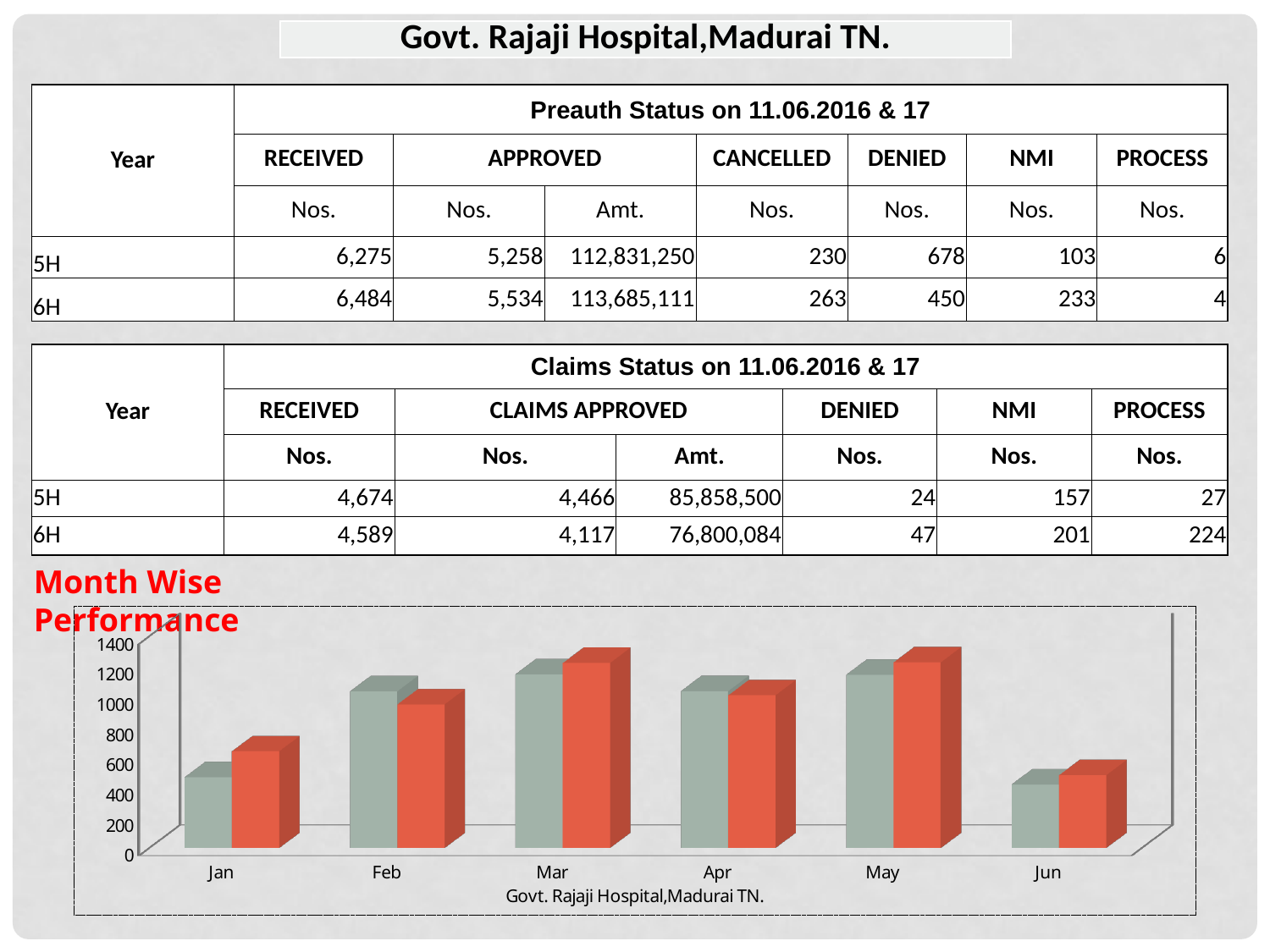
In the bar chart, is the grey bar for Mar greater or less than 1000? greater In the bar chart, do the grey bars rise or fall from Jan to Mar? rise In the bar chart, which is taller: the grey bar for Jan or the grey bar for Mar? the grey bar for Mar In the bar chart, is the grey bar for Jan greater or less than 800? less In the bar chart, is the red bar for Jun greater or less than 800? less How many months are shown on the x axis of the bar chart? 6 How many bars are plotted for each month in the bar chart? 2 What kind of chart is shown under the 'Month Wise Performance' heading? bar chart In the bar chart, which month has the lowest red bar? Jun In the bar chart, for Jan, which bar is taller: the grey bar or the red bar? the red bar What title is printed below the x axis of the bar chart? Govt. Rajaji Hospital,Madurai TN.